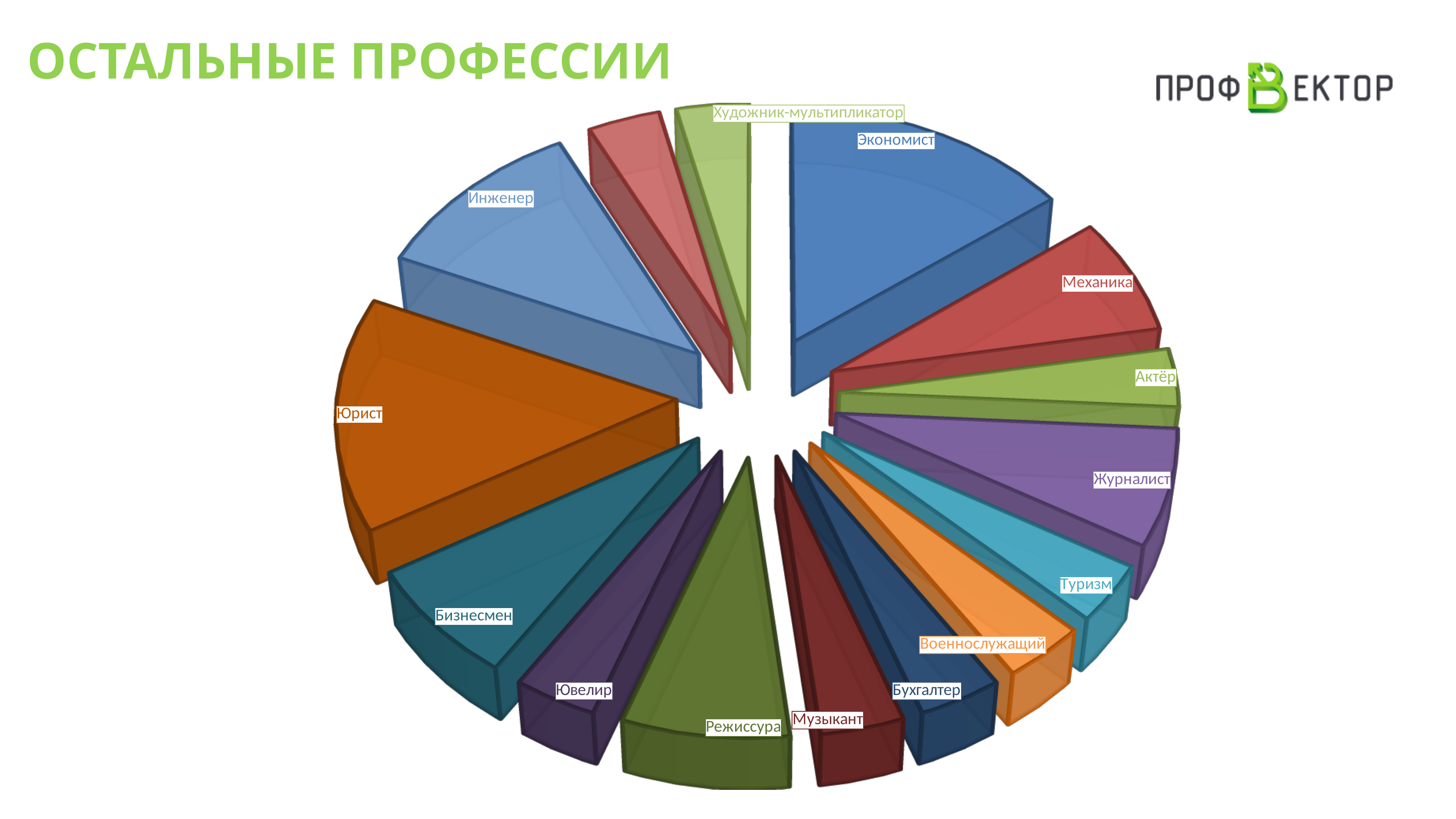
Which slice is larger, Инженер or Бухгалтер? Инженер What is the title of the slide with the pie chart? ОСТАЛЬНЫЕ ПРОФЕССИИ What kind of chart is shown on the slide? pie chart Which category label is shown on the large blue slice at the top right of the pie chart? Экономист Which slice is larger, Юрист or Актёр? Юрист Which slice is larger, Экономист or Туризм? Экономист How many slices does the pie chart have? 15